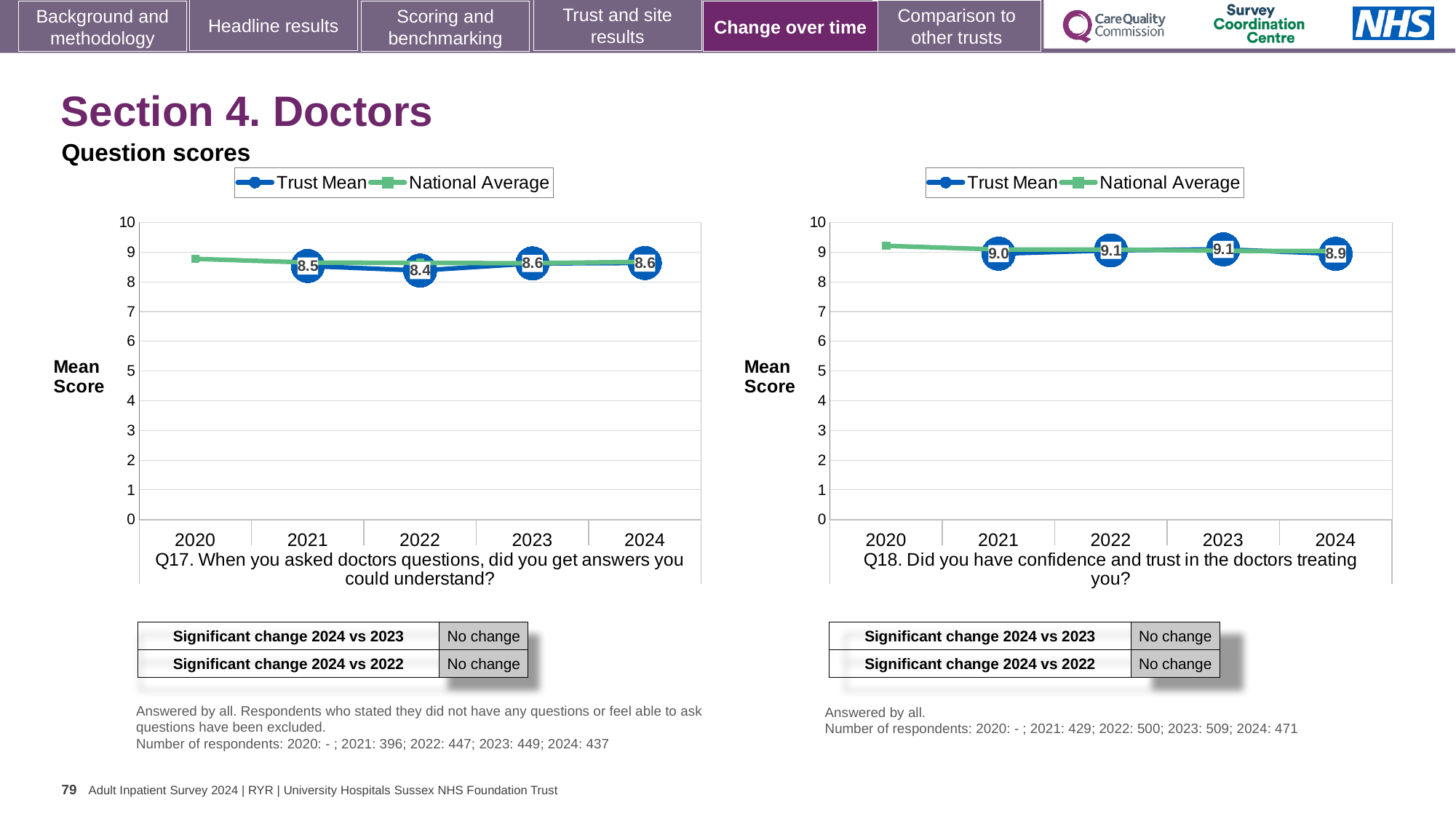
In the Q18 chart on the right, which is larger, the Trust Mean for 2023 or for 2024? 2023 How many years are shown on the x axis of the Q18 chart on the right? 5 In the Q17 chart on the left, which year has the lowest Trust Mean? 2022 In the Q17 chart on the left, what is the difference between the Trust Mean for 2024 and for 2022? 0.2 In the Q17 chart on the left, what is the Trust Mean for 2022? 8.4 In the Q18 chart on the right, what is the Trust Mean for 2024? 8.9 In the Q18 chart on the right, what is the Trust Mean for 2021? 9.0 In the Q17 chart on the left, what is the Trust Mean for 2024? 8.6 What kind of chart is the Q18 chart on the right? Line chart In the Q18 chart on the right, which year has the lowest Trust Mean? 2024 In the Q17 chart on the left, is the National Average for 2020 greater or less than 8? greater How many series does the legend of the Q17 chart on the left list? 2